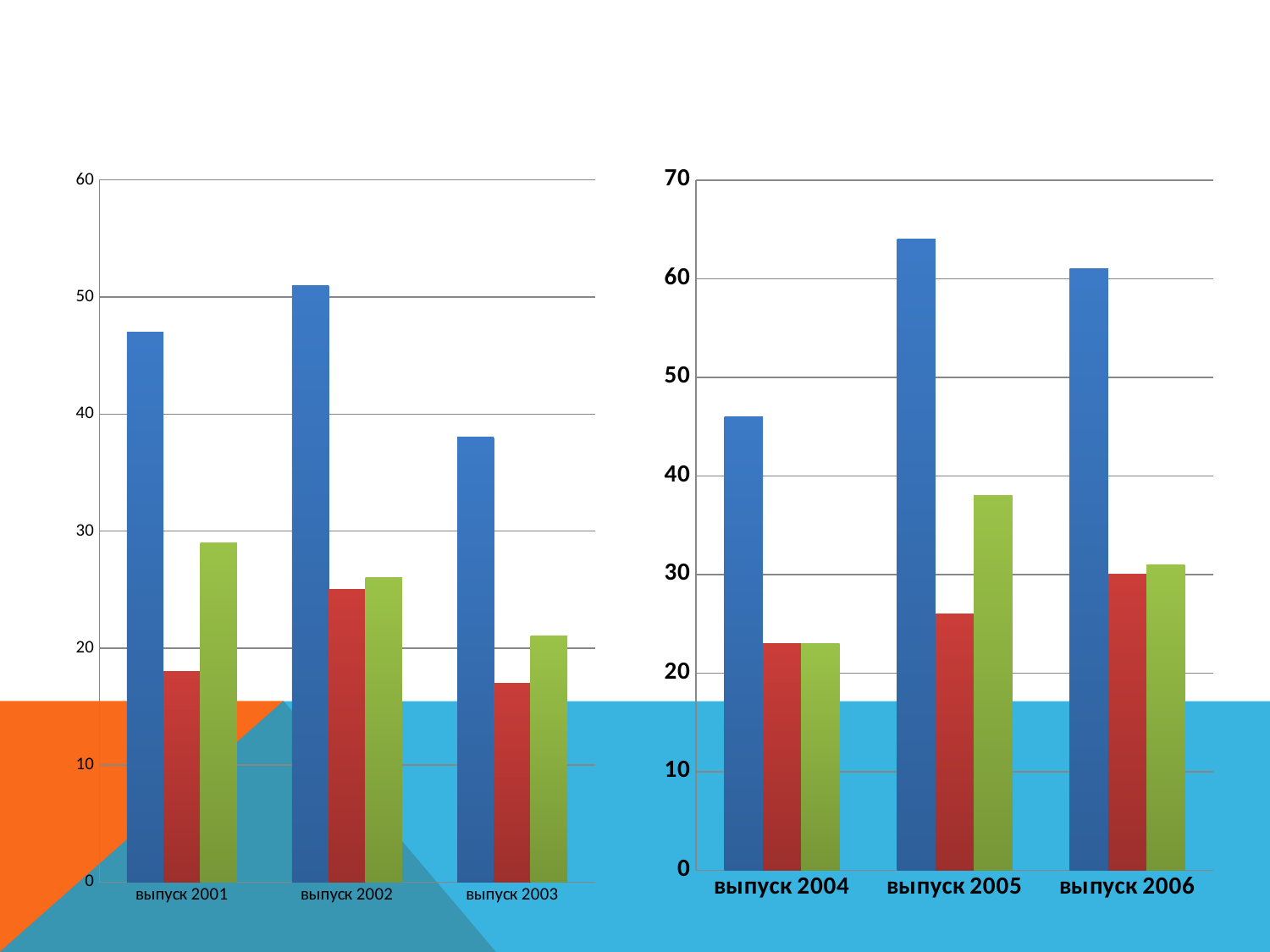
On the left chart, how many categories are shown on the x axis? 3 On the right chart, do the red bars rise or fall from выпуск 2004 to выпуск 2006? rise On the right chart, is the blue bar for выпуск 2004 greater or less than 50? less On the left chart, is the blue bar for выпуск 2003 greater or less than 40? less On the left chart, which category has the tallest blue bar? выпуск 2002 On the left chart, for выпуск 2001, which is taller: the red bar or the green bar? the green bar On the right chart, which category has the tallest blue bar? выпуск 2005 On the right chart, is the green bar for выпуск 2005 greater or less than 30? greater On the right chart, how many categories are shown on the x axis? 3 On the right chart, which category has the shortest blue bar? выпуск 2004 What kind of chart is the left chart? bar chart